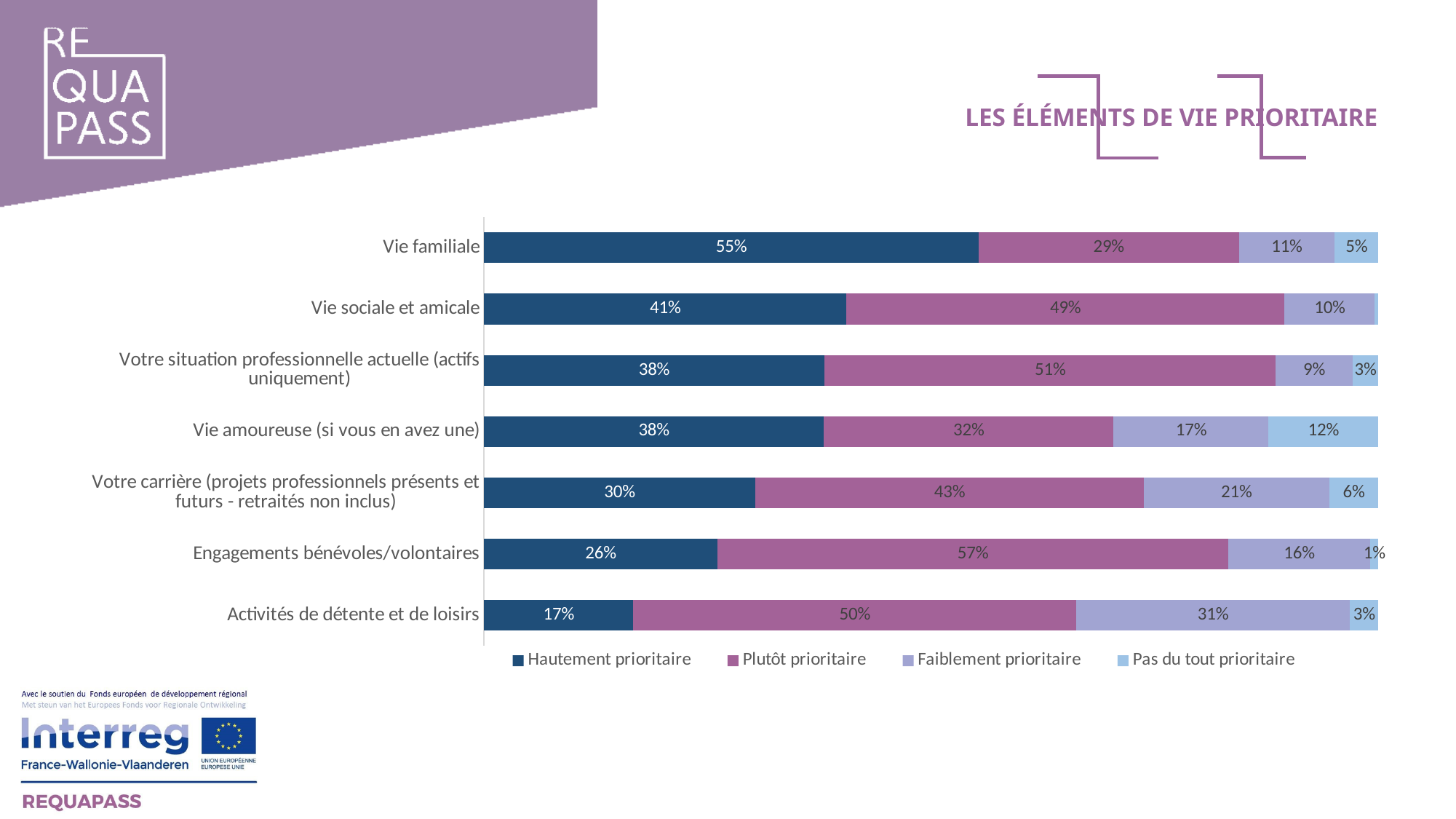
What is the "Plutôt prioritaire" value for "Engagements bénévoles/volontaires"? 57% What is the "Faiblement prioritaire" value for "Votre carrière (projets professionnels présents et futurs - retraités non inclus)"? 21% What is the difference in "Hautement prioritaire" share between "Vie familiale" and "Vie sociale et amicale"? 14 percentage points What percentage of respondents rated "Vie familiale" as "Hautement prioritaire"? 55% How many categories are shown on the chart? 7 Which category has the highest "Hautement prioritaire" share? Vie familiale How many series does the legend list? 4 Which category has the highest "Faiblement prioritaire" share? Activités de détente et de loisirs What type of chart is shown on the slide? Stacked bar chart What is the "Pas du tout prioritaire" value for "Vie amoureuse (si vous en avez une)"? 12% Which category has the lowest "Hautement prioritaire" share? Activités de détente et de loisirs Which has a larger "Plutôt prioritaire" share: "Vie sociale et amicale" or "Votre situation professionnelle actuelle (actifs uniquement)"? Votre situation professionnelle actuelle (actifs uniquement)